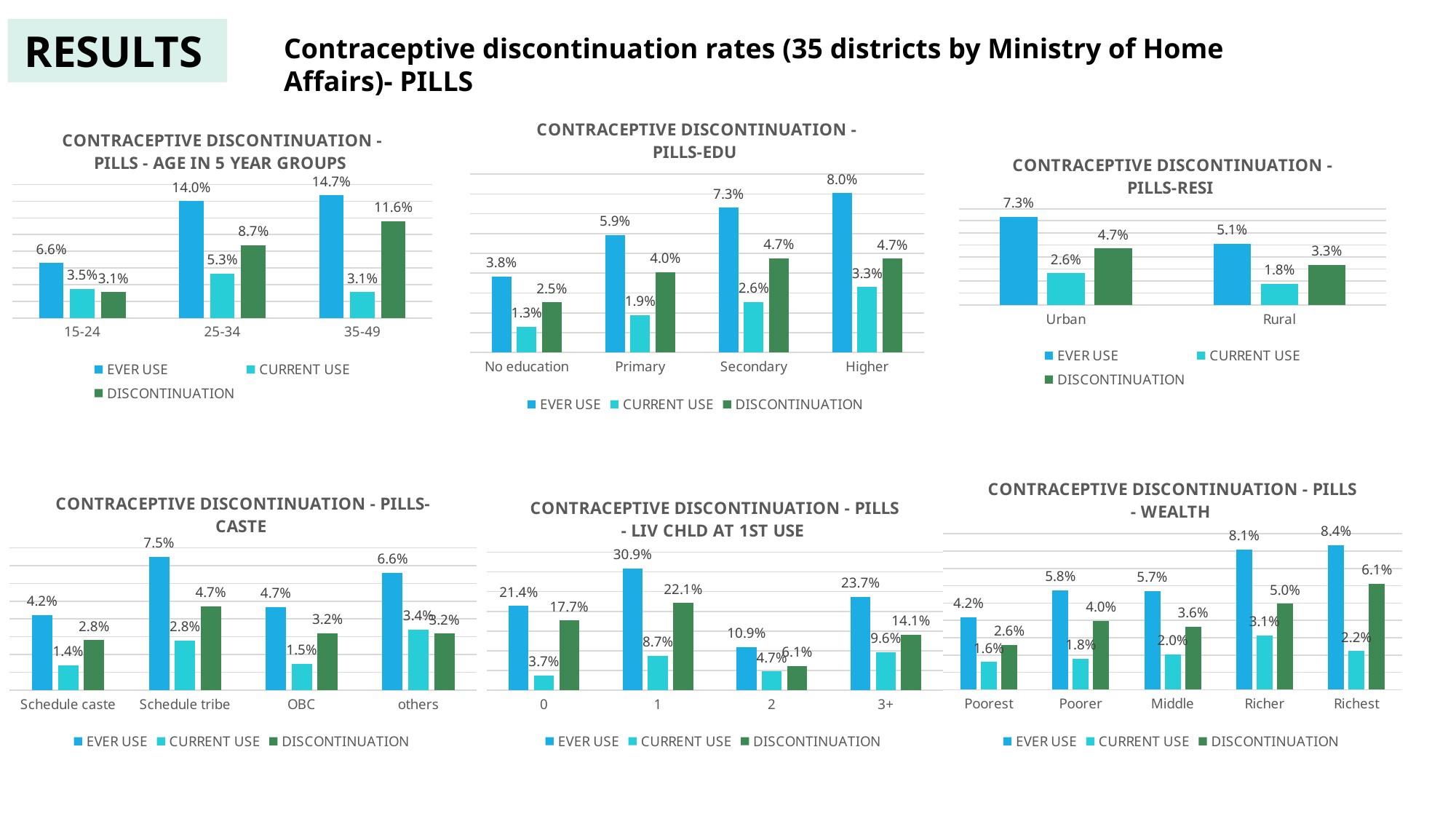
In the 'Contraceptive Discontinuation - Pills - Wealth' chart, what is the difference between the DISCONTINUATION values for Richest and Poorest? 3.5% In the 'Contraceptive Discontinuation - Pills-Edu' chart, what is the CURRENT USE value for Primary? 1.9% In the 'Contraceptive Discontinuation - Pills - Liv Chld at 1st Use' chart, which category has the lowest DISCONTINUATION value? 2 In the 'Contraceptive Discontinuation - Pills - Age in 5 Year Groups' chart, which age group has the highest EVER USE value? 35-49 What kind of chart is the 'Contraceptive Discontinuation - Pills - Wealth' chart? Bar chart In the 'Contraceptive Discontinuation - Pills-Edu' chart, what is the difference between the EVER USE values for Higher and No education? 4.2% In the 'Contraceptive Discontinuation - Pills-Resi' chart, how many series does the legend list? 3 In the 'Contraceptive Discontinuation - Pills-Resi' chart, which has the larger DISCONTINUATION value, Urban or Rural? Urban In the 'Contraceptive Discontinuation - Pills-Caste' chart, how many caste categories are shown on the x axis? 4 In the 'Contraceptive Discontinuation - Pills-Caste' chart, which caste category has the lowest CURRENT USE value? Schedule caste In the 'Contraceptive Discontinuation - Pills - Liv Chld at 1st Use' chart, what is the EVER USE value for category 1? 30.9% In the 'Contraceptive Discontinuation - Pills - Age in 5 Year Groups' chart, what is the DISCONTINUATION value for the 35-49 age group? 11.6%